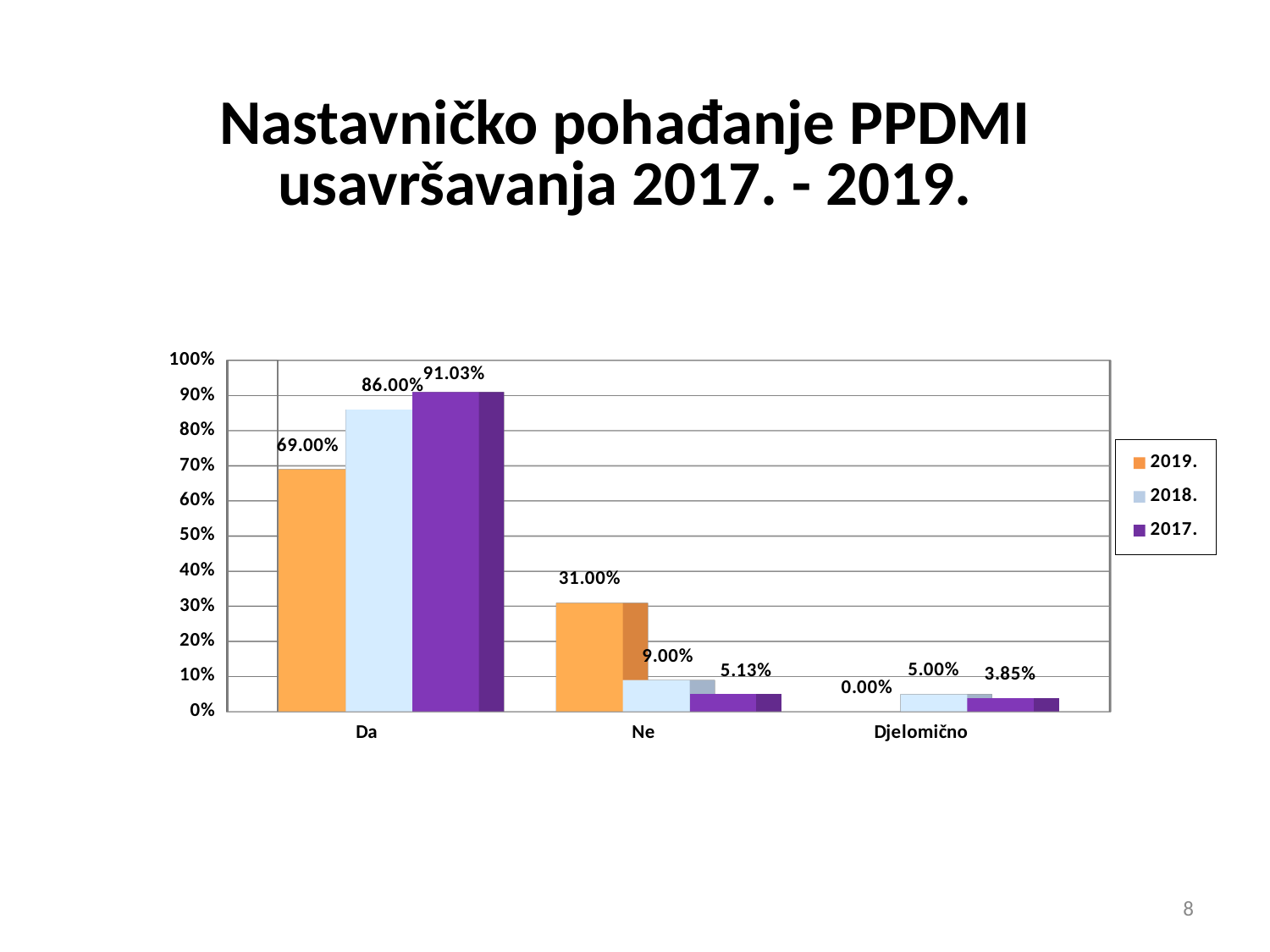
What is the title of the slide? Nastavničko pohađanje PPDMI usavršavanja 2017. - 2019. What kind of chart is shown on the slide? bar chart Which series has the lowest value in the Ne category? 2017. What is the difference between the 2018. and 2019. values in the Da category? 17.00% Which series has the highest value in the Da category? 2017. What is the value for 2019. in the Da category? 69.00% How many series does the legend list? 3 What is the value for 2019. in the Djelomično category? 0.00% What is the value for 2017. in the Da category? 91.03% What is the value for 2018. in the Ne category? 9.00% How many categories are shown on the x axis? 3 Which is larger: the 2019. value for Ne or the 2018. value for Ne? 2019.